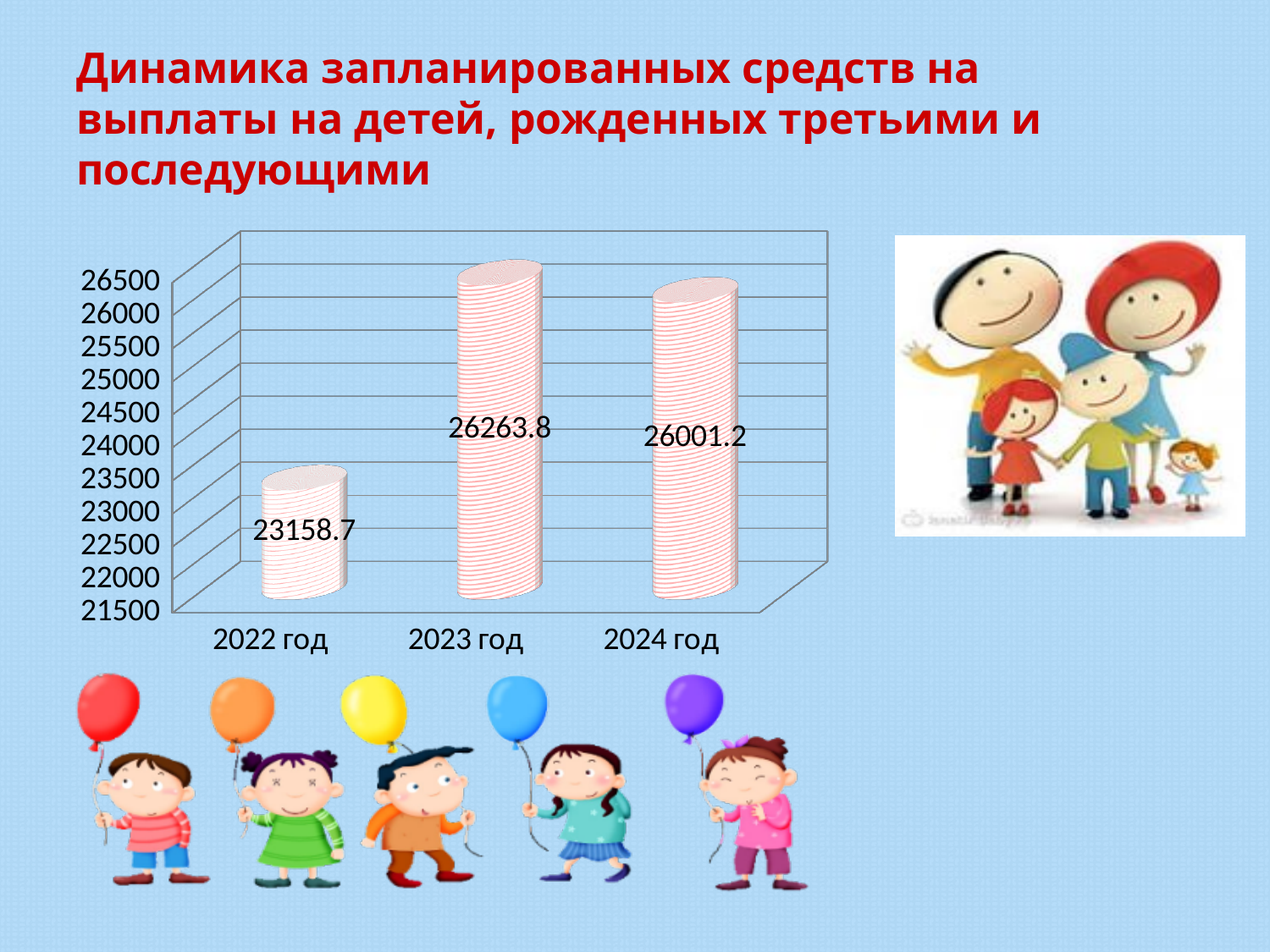
What is the value for 2023 год? 26263.8 Which year has the lowest value? 2022 год Is the value for 2022 год greater or less than 24000? less Which is larger, the value for 2024 год or the value for 2022 год? 2024 год What is the difference between the values for 2023 год and 2024 год? 262.6 Which year has the highest value? 2023 год Does the value rise or fall from 2022 год to 2023 год? rise What is the difference between the values for 2023 год and 2022 год? 3105.1 What kind of chart is shown on the slide? bar chart What is the value for 2022 год? 23158.7 How many categories are shown on the x axis? 3 What is the value for 2024 год? 26001.2